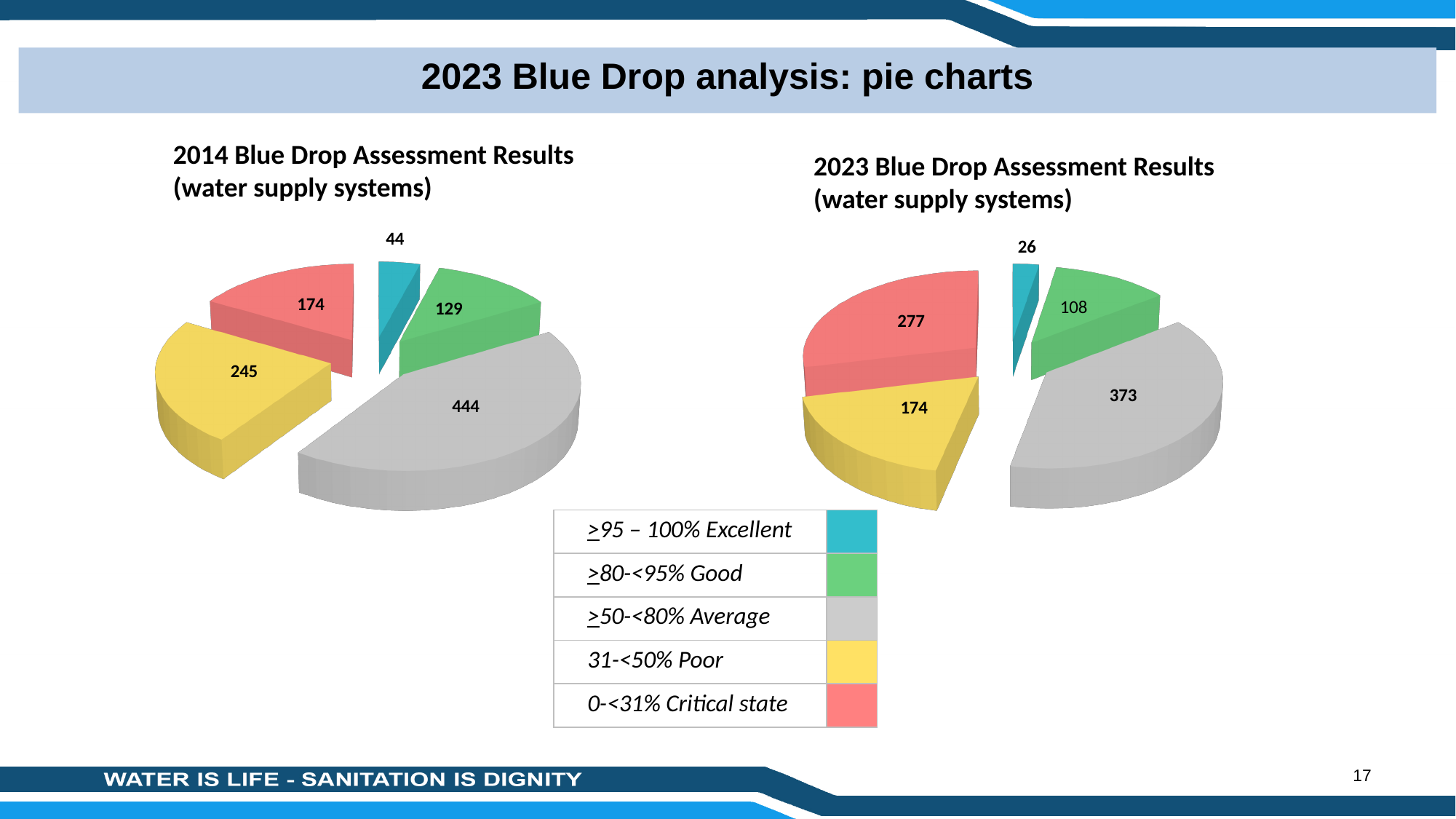
In the 2023 Blue Drop Assessment Results pie chart, how many water supply systems are in the Critical state (0-<31%) category? 277 In the 2014 Blue Drop Assessment Results pie chart, how many water supply systems are in the Average (≥50-<80%) category? 444 What type of chart is used on this slide? Pie chart In the 2023 Blue Drop Assessment Results pie chart, which category has the smallest slice? ≥95 – 100% Excellent What is the difference between the Critical state values in the 2023 chart (277) and the 2014 chart (174)? 103 Which is larger: the Poor category in the 2014 chart or the Poor category in the 2023 chart? 2014 chart (245) In the 2014 Blue Drop Assessment Results pie chart, which category has the largest slice? ≥50-<80% Average In the 2014 Blue Drop Assessment Results pie chart, what is the difference between the Poor and Good categories? 116 What is the total number of water supply systems shown in the 2023 Blue Drop Assessment Results pie chart? 958 In the 2023 Blue Drop Assessment Results pie chart, what is the value for the Excellent (≥95-100%) category? 26 Which colour represents the Critical state (0-<31%) category in the legend? Red How many categories does each pie chart show? 5